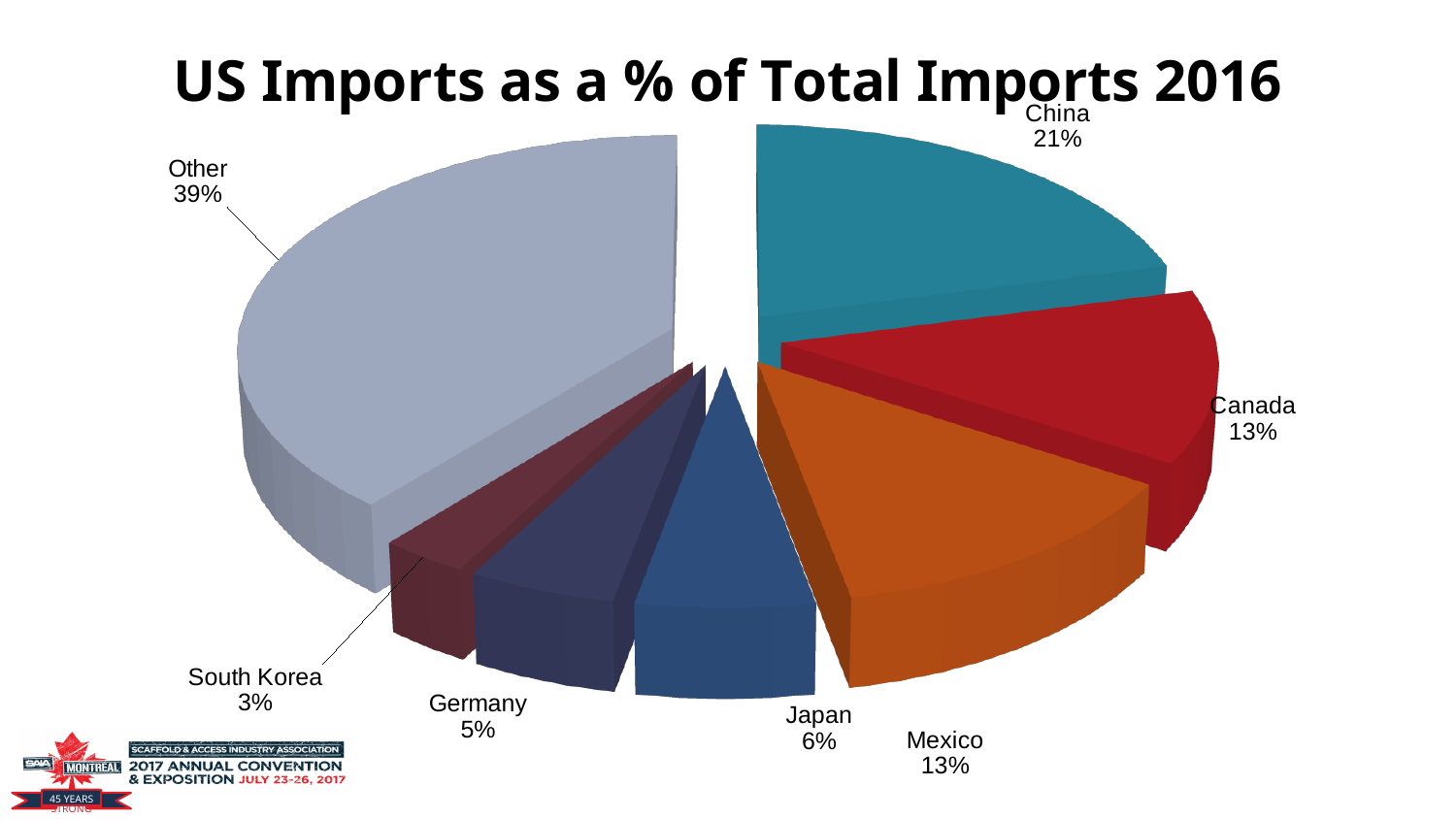
What type of chart is shown on the slide? pie chart What percentage of total US imports in 2016 came from Japan? 6% How many percentage points larger is China's share than Canada's share? 8 percentage points Which named country has the smallest share of US imports in the chart? South Korea How many slices does the pie chart have? 7 What percentage of total US imports in 2016 came from Germany? 5% What percentage of total US imports in 2016 came from China? 21% Which has a larger share of US imports, China or Canada? China What percentage of total US imports in 2016 came from Mexico? 13% What share of the pie does the Other slice represent? 39% Which slice of the pie chart is the largest? Other What is the title of the chart? US Imports as a % of Total Imports 2016